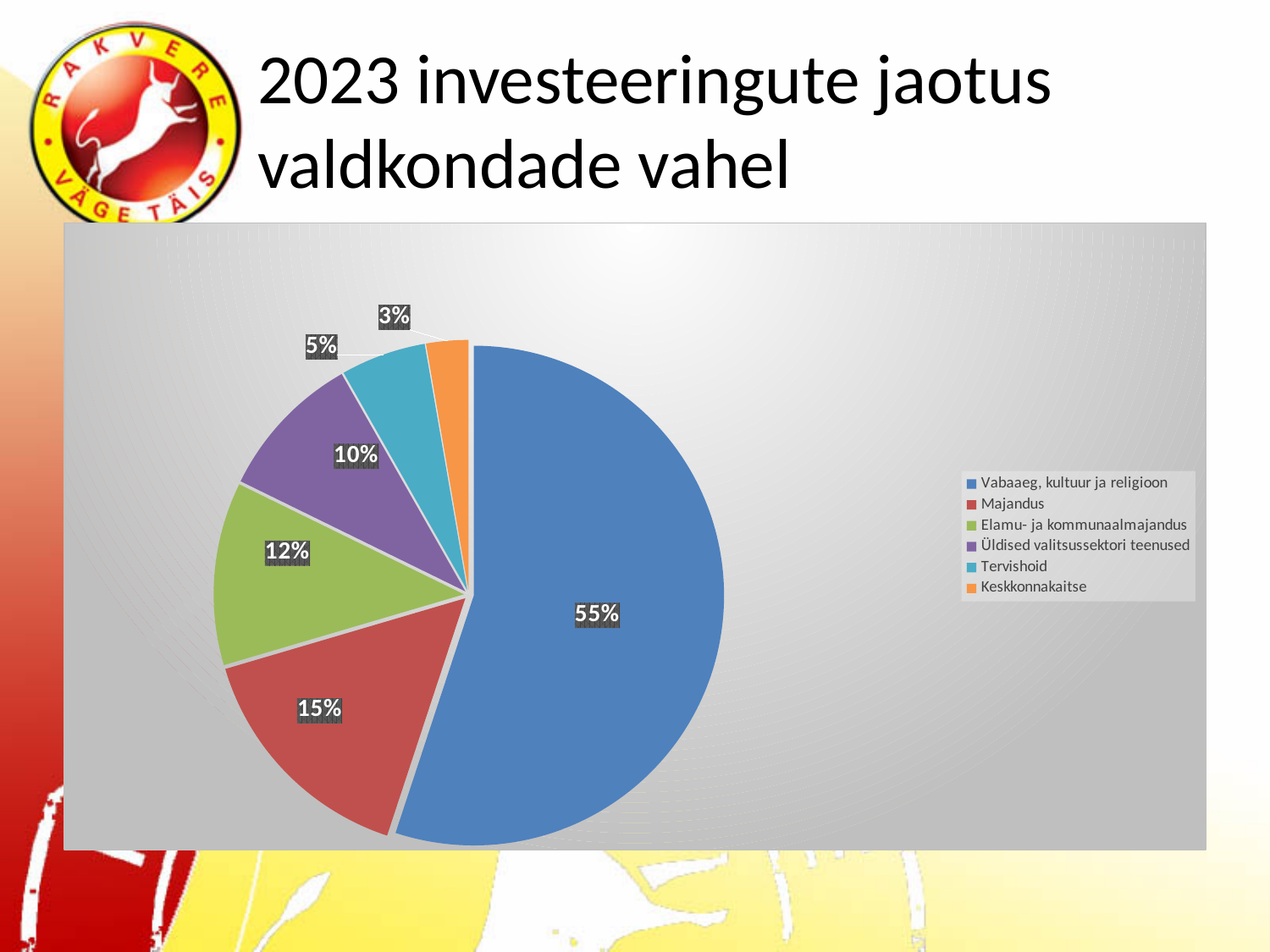
What share of the pie does Elamu- ja kommunaalmajandus have? 12% What share of the pie does Vabaaeg, kultuur ja religioon have? 55% Which category has the largest slice of the pie? Vabaaeg, kultuur ja religioon What share of the pie does Majandus have? 15% Which is larger, the share for Elamu- ja kommunaalmajandus or the share for Üldised valitsussektori teenused? Elamu- ja kommunaalmajandus How many categories does the legend list? 6 What is the difference in percentage points between Majandus and Tervishoid? 10 What kind of chart is shown on the slide? pie chart Which category has the smallest slice of the pie? Keskkonnakaitse